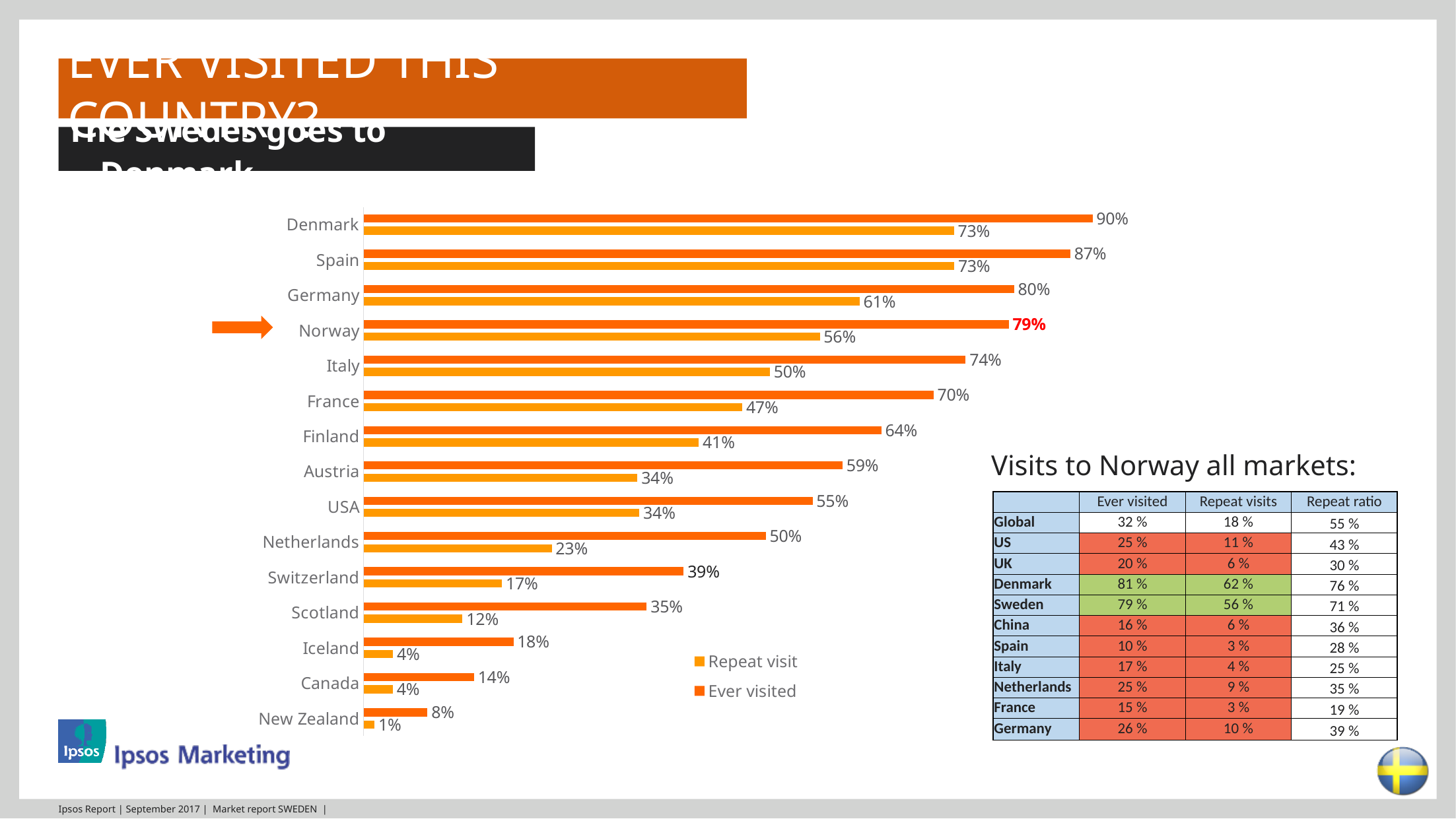
What kind of chart is shown on the slide? bar chart What is the 'Repeat visit' value for Germany? 61% Which series in the legend is shown in the lighter orange colour? Repeat visit How many countries are shown in the bar chart? 15 What is the difference between the 'Ever visited' and 'Repeat visit' values for Finland? 23% Which is larger: the 'Ever visited' value for Italy or for France? Italy How many series does the chart legend list? 2 Do the 'Ever visited' values rise or fall going down the list of countries from Denmark to New Zealand? fall What is the 'Ever visited' value for Switzerland? 39% Which country has the highest 'Ever visited' value? Denmark What is the 'Ever visited' value for Norway? 79% Which country has the lowest 'Repeat visit' value? New Zealand